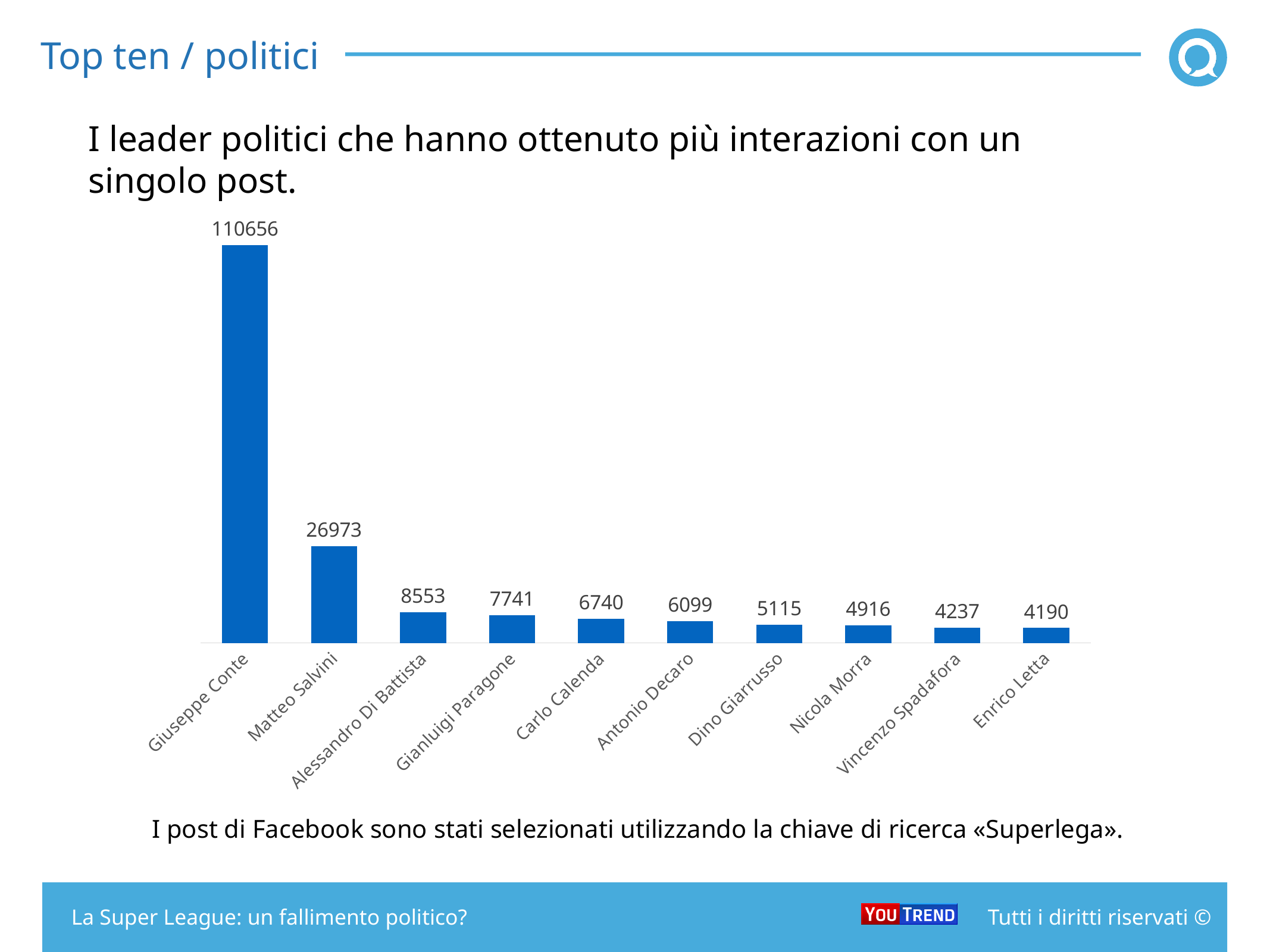
What is the value for Giuseppe Conte? 110656 Which politician has the lowest value? Enrico Letta What is the value for Enrico Letta? 4190 Which is larger, the value for Antonio Decaro or the value for Dino Giarrusso? Antonio Decaro What is the value for Carlo Calenda? 6740 What kind of chart is shown on the slide? Bar chart How many politicians are shown in the chart? 10 What is the difference between the values for Alessandro Di Battista and Gianluigi Paragone? 812 What is the difference between the values for Giuseppe Conte and Matteo Salvini? 83683 Do the values rise or fall from left to right along the x axis? Fall Which politician has the highest value? Giuseppe Conte What is the value for Matteo Salvini? 26973